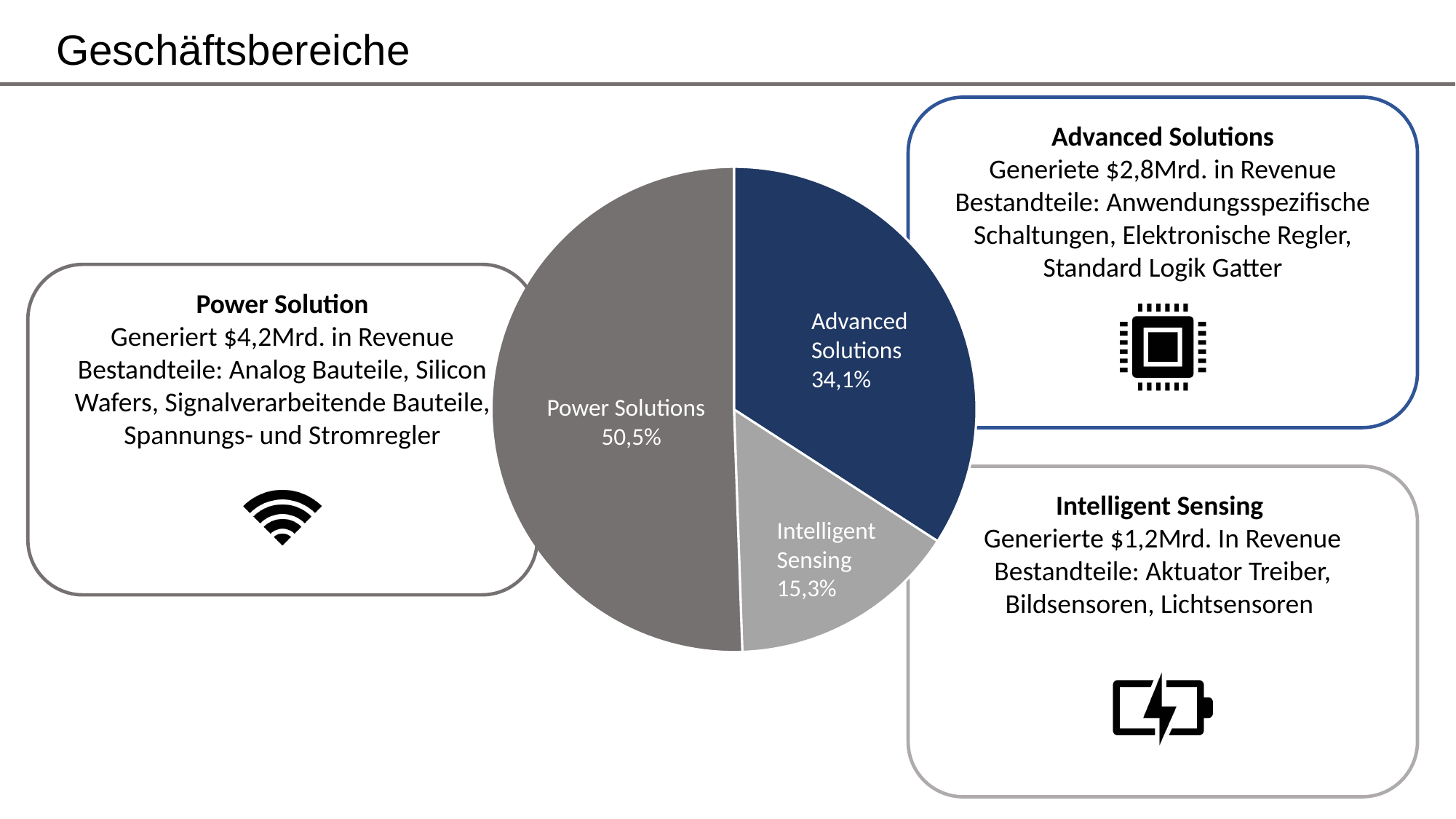
What share of the pie does Power Solutions have? 50,5% Which is larger, the share for Advanced Solutions or the share for Intelligent Sensing? Advanced Solutions Which segment has the smallest share of the pie? Intelligent Sensing What kind of chart is shown on the slide? pie chart Is the share for Power Solutions greater or less than 50%? greater What colour is the Advanced Solutions segment of the pie? dark blue What share of the pie does Intelligent Sensing have? 15,3% What is the difference in percentage points between Power Solutions and Advanced Solutions? 16,4 What is the difference in percentage points between Advanced Solutions and Intelligent Sensing? 18,8 What share of the pie does Advanced Solutions have? 34,1% How many segments does the pie chart have? 3 Which segment has the largest share of the pie? Power Solutions